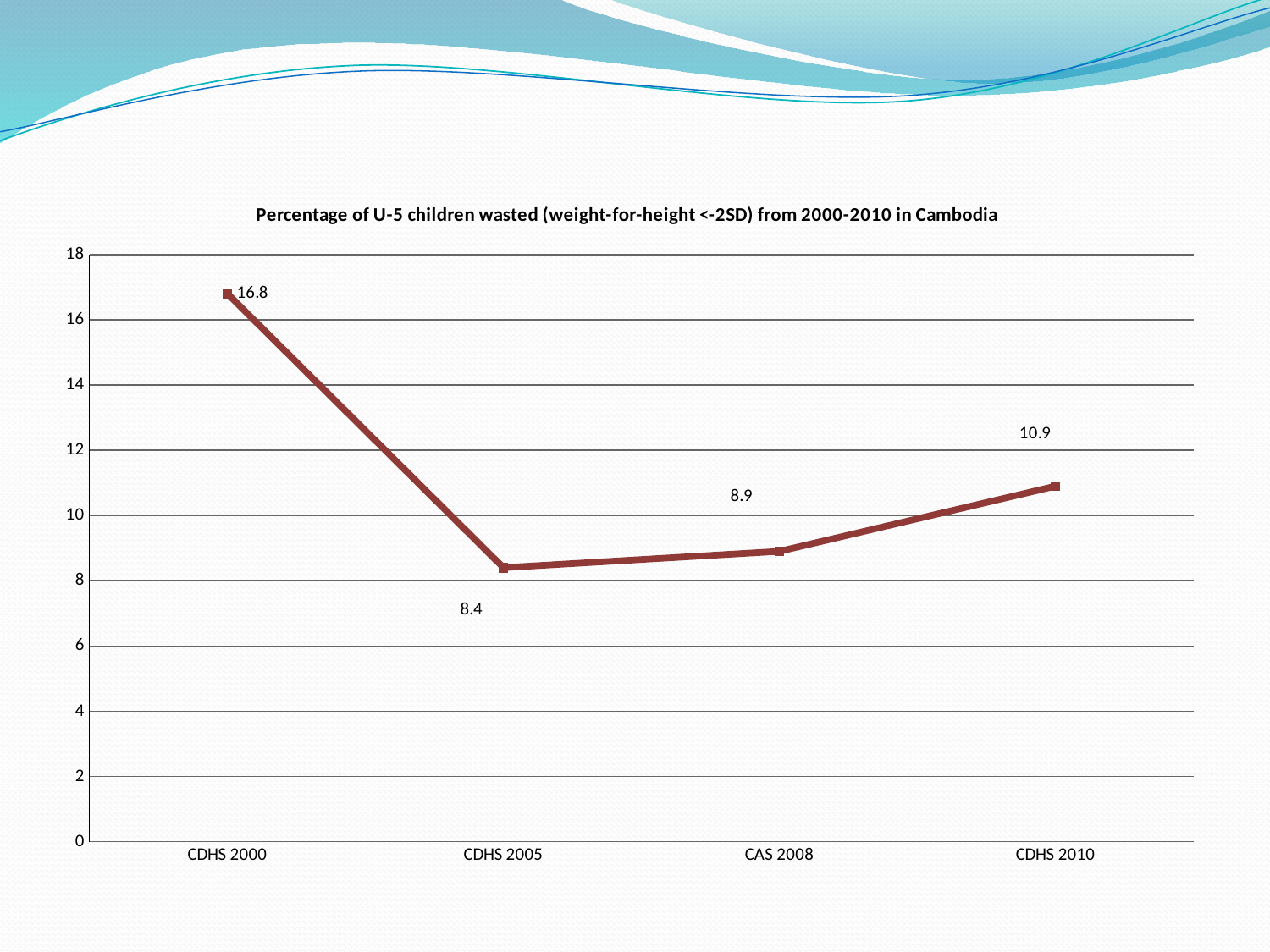
Which survey has the lowest percentage of wasted children? CDHS 2005 What is the difference between the values for CDHS 2010 and CAS 2008? 2 What is the value for CDHS 2010? 10.9 What is the value for CAS 2008? 8.9 What is the title of the chart? Percentage of U-5 children wasted (weight-for-height <-2SD) from 2000-2010 in Cambodia What is the difference between the values for CDHS 2000 and CDHS 2005? 8.4 How many data points are plotted on the chart? 4 What kind of chart is shown on the slide? Line chart Which is larger, the value for CAS 2008 or the value for CDHS 2010? CDHS 2010 Which survey has the highest percentage of wasted children? CDHS 2000 What is the value for CDHS 2000? 16.8 What is the value for CDHS 2005? 8.4